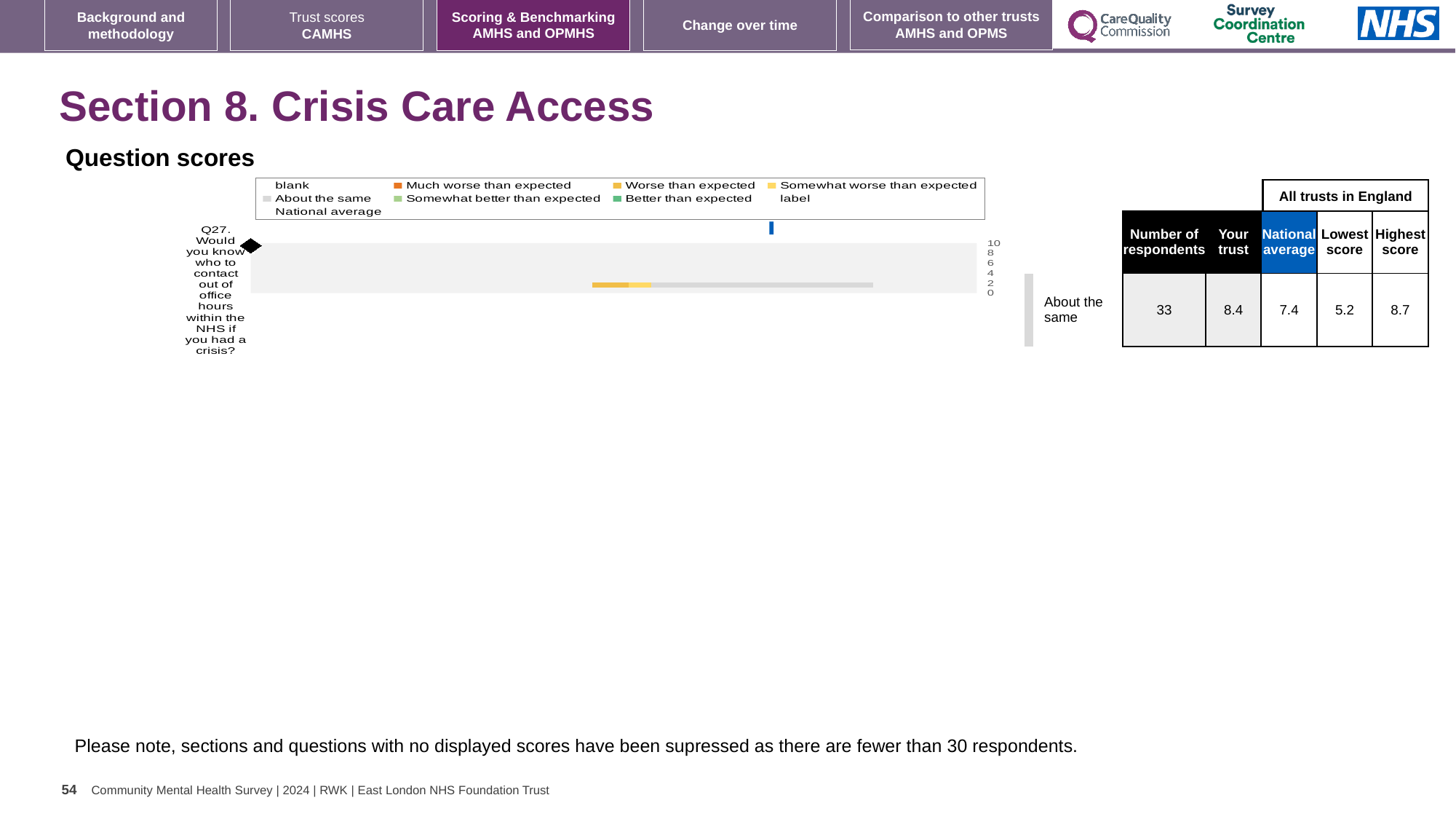
What is the national average score for Q27? 7.4 What is the question number of the item plotted in the question scores chart? Q27 Which is larger for Q27, the 'Your trust' score or the national average? Your trust What is the 'Your trust' score for Q27? 8.4 What is the difference between the highest and lowest scores among all trusts in England for Q27? 3.5 How many respondents answered Q27? 33 What is the difference between the 'Your trust' score and the national average for Q27? 1.0 How many questions are plotted in the question scores chart? 1 What benchmark category label is shown next to the chart for Q27? About the same What kind of chart is used to show the question scores? bar chart What is the lowest score among all trusts in England for Q27? 5.2 What is the highest score among all trusts in England for Q27? 8.7